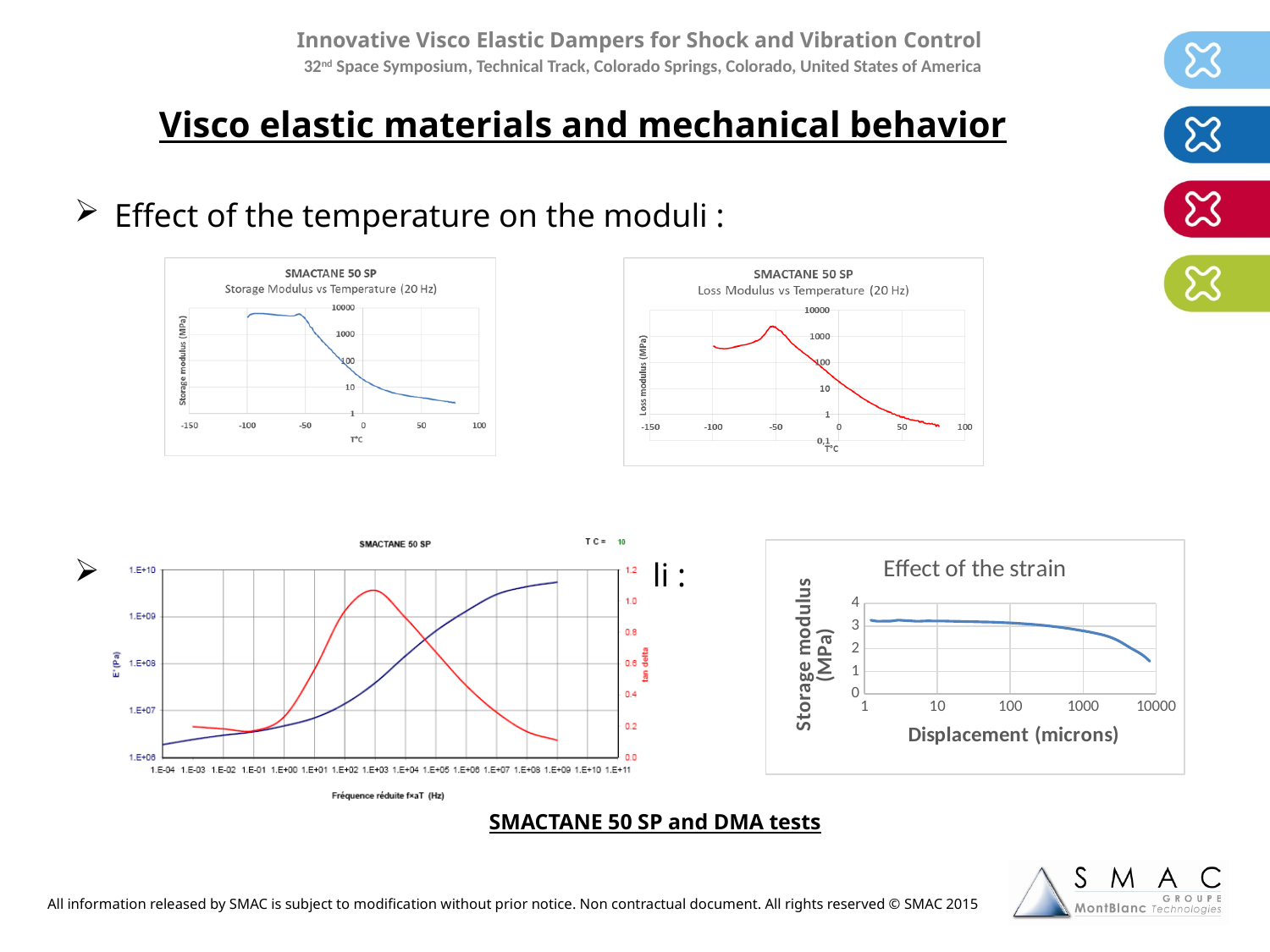
What kind of chart is the 'Effect of the strain' chart? line chart In the 'Storage Modulus vs Temperature (20 Hz)' chart, is the storage modulus at 50 °C greater or less than 10 MPa? less In the 'Effect of the strain' chart, is the storage modulus at a displacement of 10 microns greater or less than 2 MPa? greater In the bottom-left frequency chart, is the peak value of the red tan delta curve greater or less than 0.8? greater In the 'Storage Modulus vs Temperature (20 Hz)' chart, does the storage modulus rise or fall as temperature increases from -50 to 100 °C? fall What is the x-axis label of the 'Effect of the strain' chart? Displacement (microns) In the 'Effect of the strain' chart, does the storage modulus rise or fall as displacement increases? fall What is the title of the top-right chart? SMACTANE 50 SP Loss Modulus vs Temperature (20 Hz)